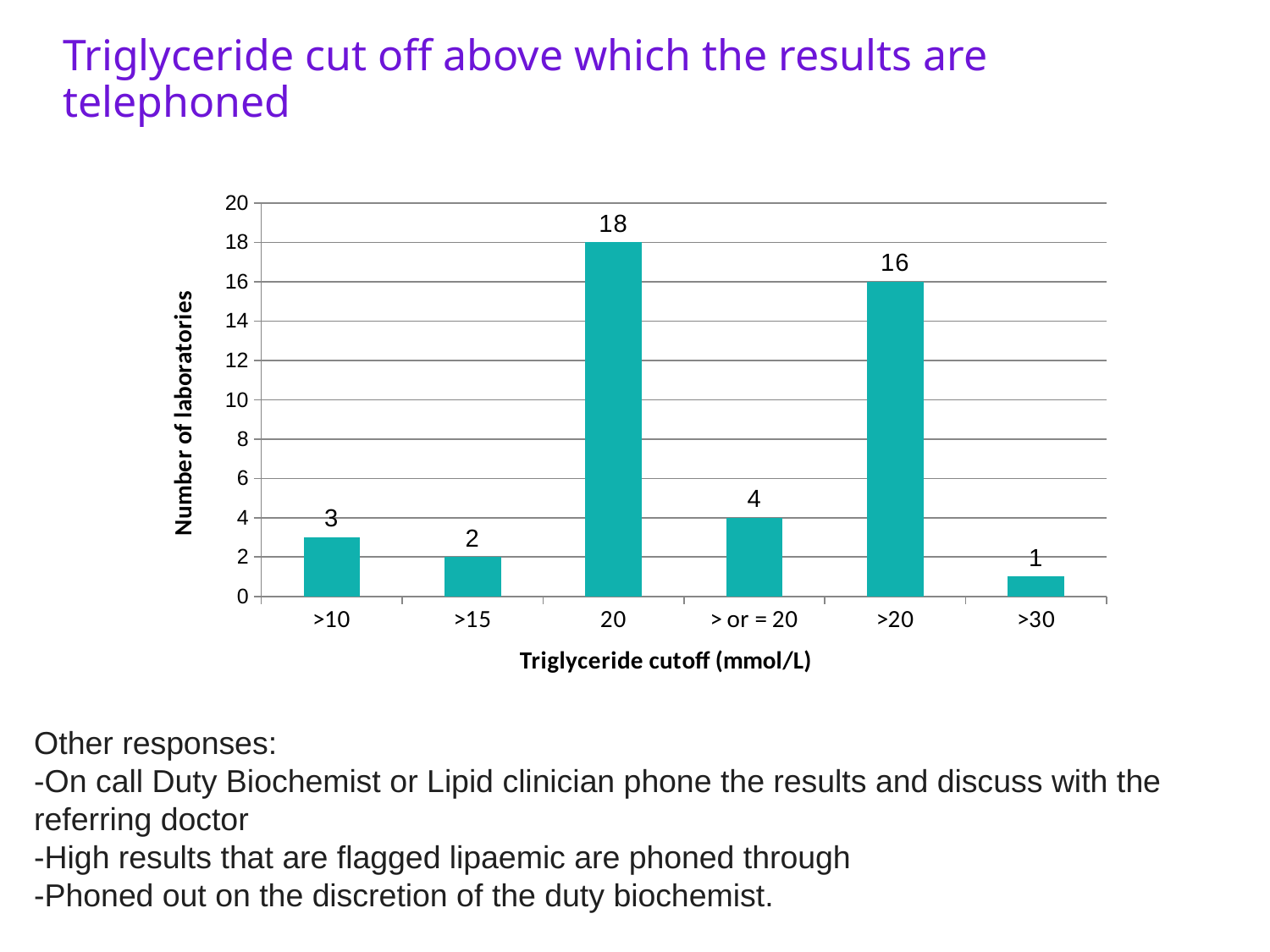
What is the difference in the number of laboratories between the 20 and >20 cutoff categories? 2 How many laboratories use a triglyceride cutoff of >10 mmol/L? 3 Which triglyceride cutoff category has the highest number of laboratories? 20 How many triglyceride cutoff categories are shown on the x axis? 6 Which has more laboratories: the >15 cutoff or the > or = 20 cutoff? > or = 20 What type of chart is shown on the slide? Bar chart How many laboratories use a triglyceride cutoff of 20 mmol/L? 18 What is the label of the x axis of the chart? Triglyceride cutoff (mmol/L) Which triglyceride cutoff category has the lowest number of laboratories? >30 Is the number of laboratories for the >20 cutoff greater or less than 10? greater What is the label of the y axis of the chart? Number of laboratories How many laboratories use a triglyceride cutoff of >20 mmol/L? 16